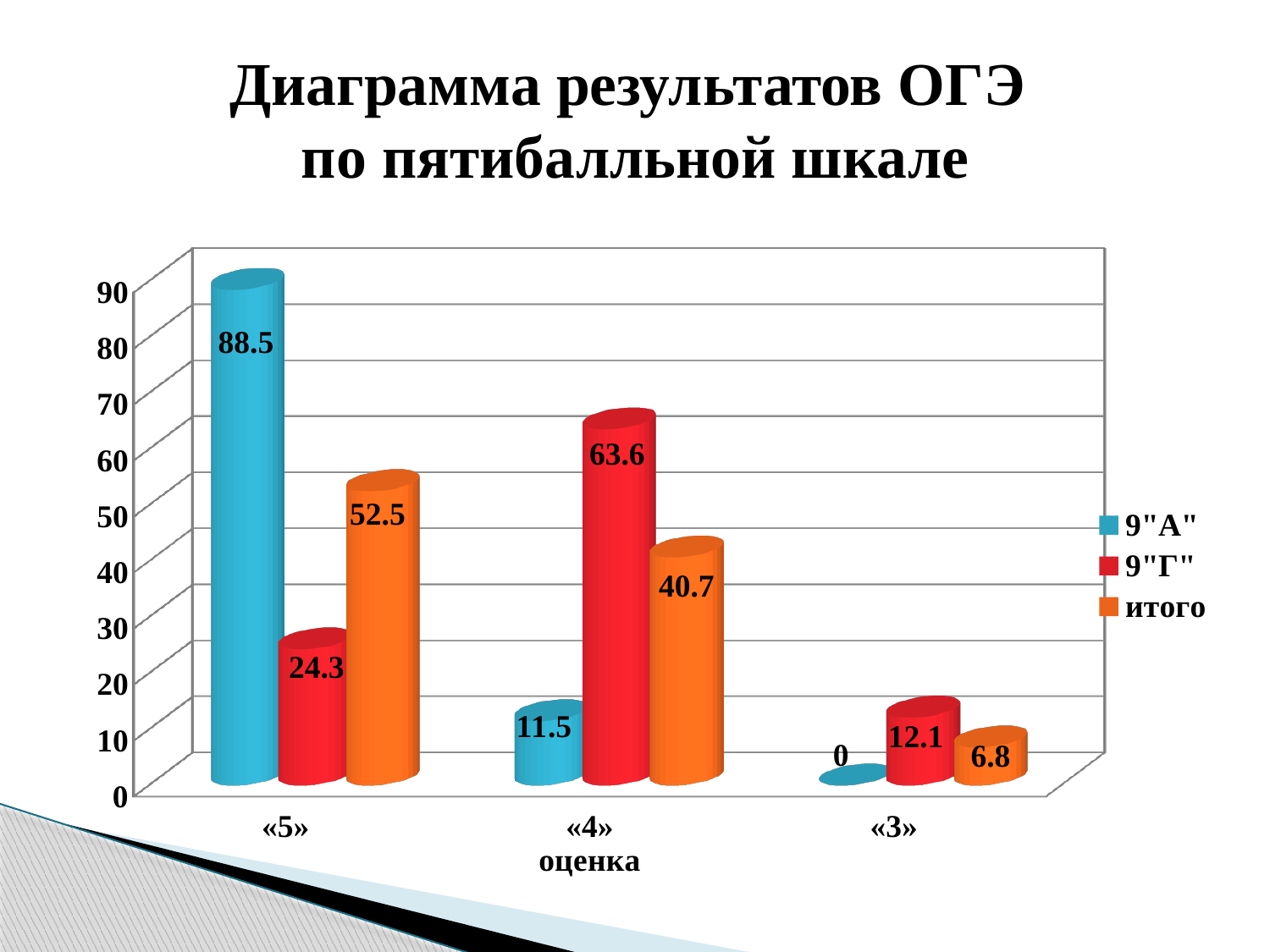
What is the label of the x axis? оценка What kind of chart is shown on the slide? bar chart Which grade has the lowest value for the итого series? «3» Which grade has the highest value for the 9"Г" series? «4» What is the value for 9"А" at grade «5»? 88.5 How many series does the legend list? 3 What is the value for 9"А" at grade «3»? 0 What is the value for 9"Г" at grade «4»? 63.6 Which is larger at grade «4»: the value for 9"А" or for итого? итого How many grade categories are shown on the x axis? 3 What is the difference between the 9"А" and 9"Г" values at grade «5»? 64.2 What is the value for итого at grade «3»? 6.8